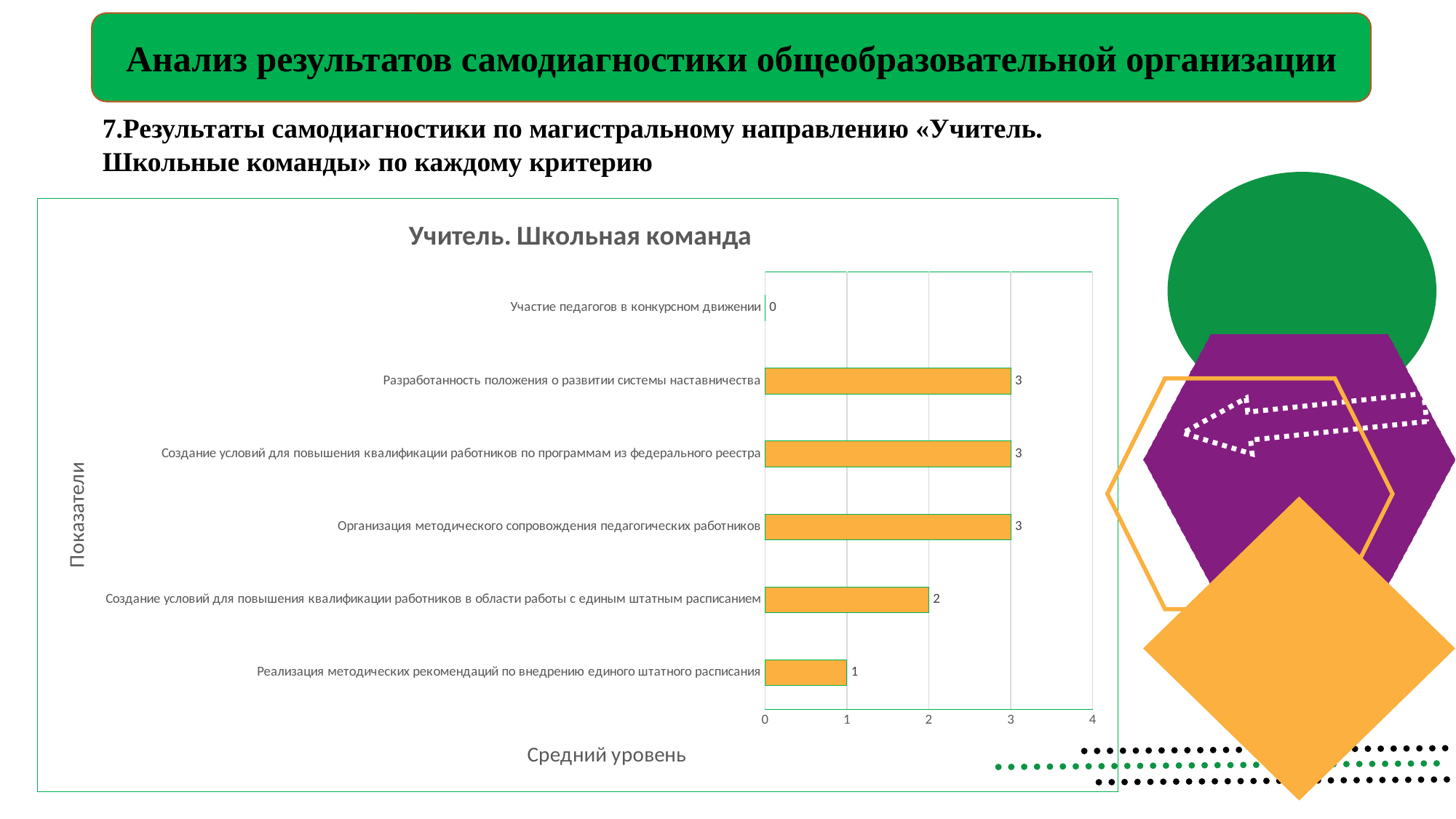
How many categories (indicators) are plotted in the chart? 6 Which is larger: the value for «Создание условий для повышения квалификации работников по программам из федерального реестра» or the value for «Создание условий для повышения квалификации работников в области работы с единым штатным расписанием»? Создание условий для повышения квалификации работников по программам из федерального реестра What is the value for «Создание условий для повышения квалификации работников в области работы с единым штатным расписанием»? 2 What is the title of the chart? Учитель. Школьная команда What is the value for «Участие педагогов в конкурсном движении»? 0 What is the value for «Реализация методических рекомендаций по внедрению единого штатного расписания»? 1 Which indicator has the lowest value in the chart? Участие педагогов в конкурсном движении What type of chart is shown on the slide? bar chart How many indicators have a value of 3? 3 What is the value for «Разработанность положения о развитии системы наставничества»? 3 What is the label of the horizontal axis of the chart? Средний уровень What is the difference between the value for «Организация методического сопровождения педагогических работников» and the value for «Реализация методических рекомендаций по внедрению единого штатного расписания»? 2